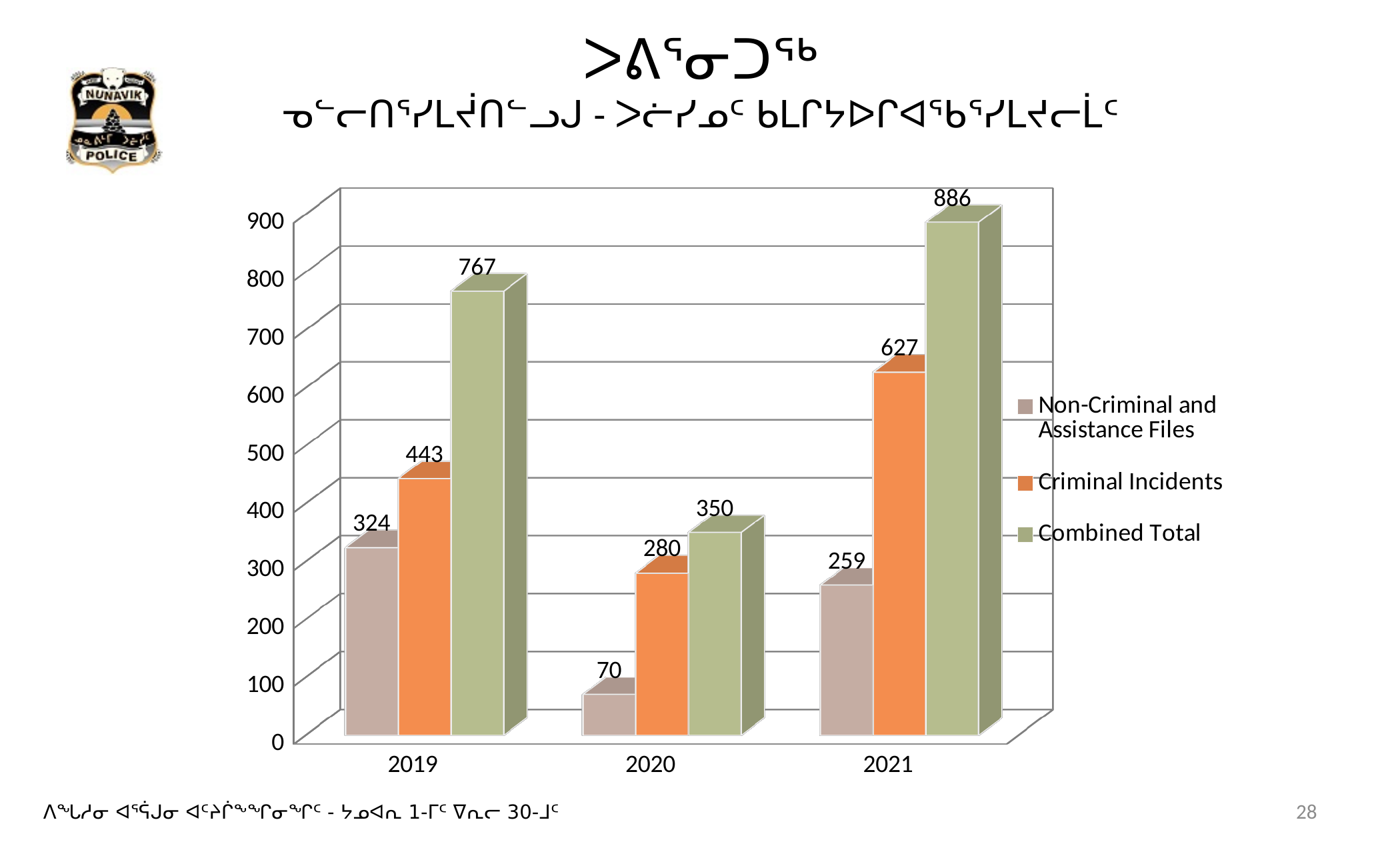
How many years are shown on the x axis? 3 What is the value for Criminal Incidents in 2019? 443 What is the Combined Total for 2021? 886 Which is larger: Non-Criminal and Assistance Files in 2019 or in 2021? 2019 What is the difference between the Combined Total in 2021 and in 2020? 536 How many series does the legend list? 3 What kind of chart is shown on the slide? Bar chart Which year has the lowest value for Non-Criminal and Assistance Files? 2020 What is the difference between Criminal Incidents in 2021 and in 2019? 184 Which year has the highest Combined Total? 2021 What is the value for Non-Criminal and Assistance Files in 2020? 70 What is the value for Criminal Incidents in 2021? 627